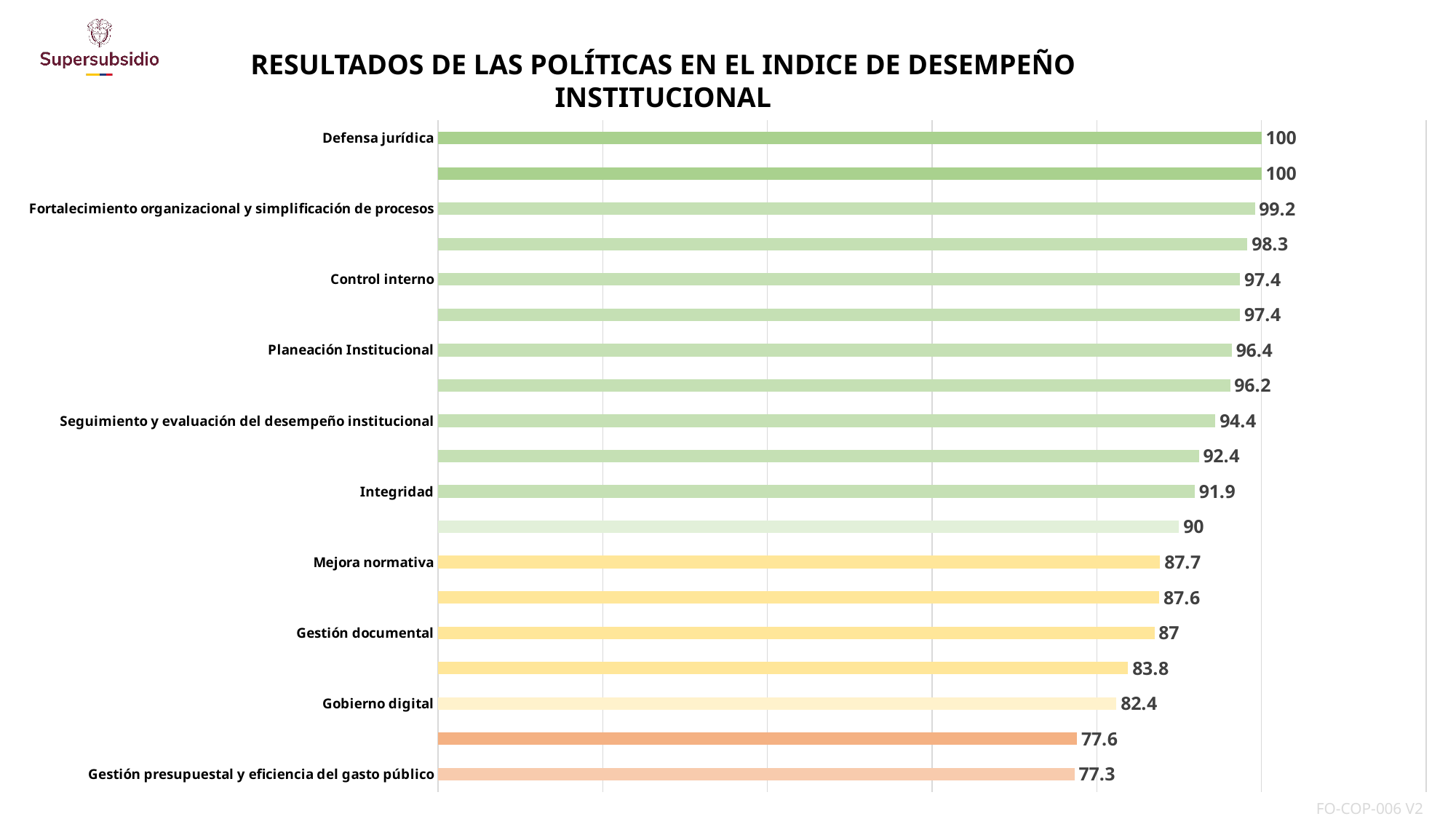
What is the value for Fortalecimiento organizacional y simplificación de procesos? 99.2 Which has a higher value, Mejora normativa or Gestión documental? Mejora normativa What is the title of the chart? RESULTADOS DE LAS POLÍTICAS EN EL INDICE DE DESEMPEÑO INSTITUCIONAL What is the value for Control interno? 97.4 What is the value for Gestión presupuestal y eficiencia del gasto público? 77.3 What is the difference between the values for Defensa jurídica and Gestión presupuestal y eficiencia del gasto público? 22.7 What is the value for Defensa jurídica? 100 How many bars are plotted on the chart? 19 What kind of chart is shown on the slide? Bar chart What is the lowest value shown on the chart? 77.3 What is the value for Gobierno digital? 82.4 What is the value for Integridad? 91.9